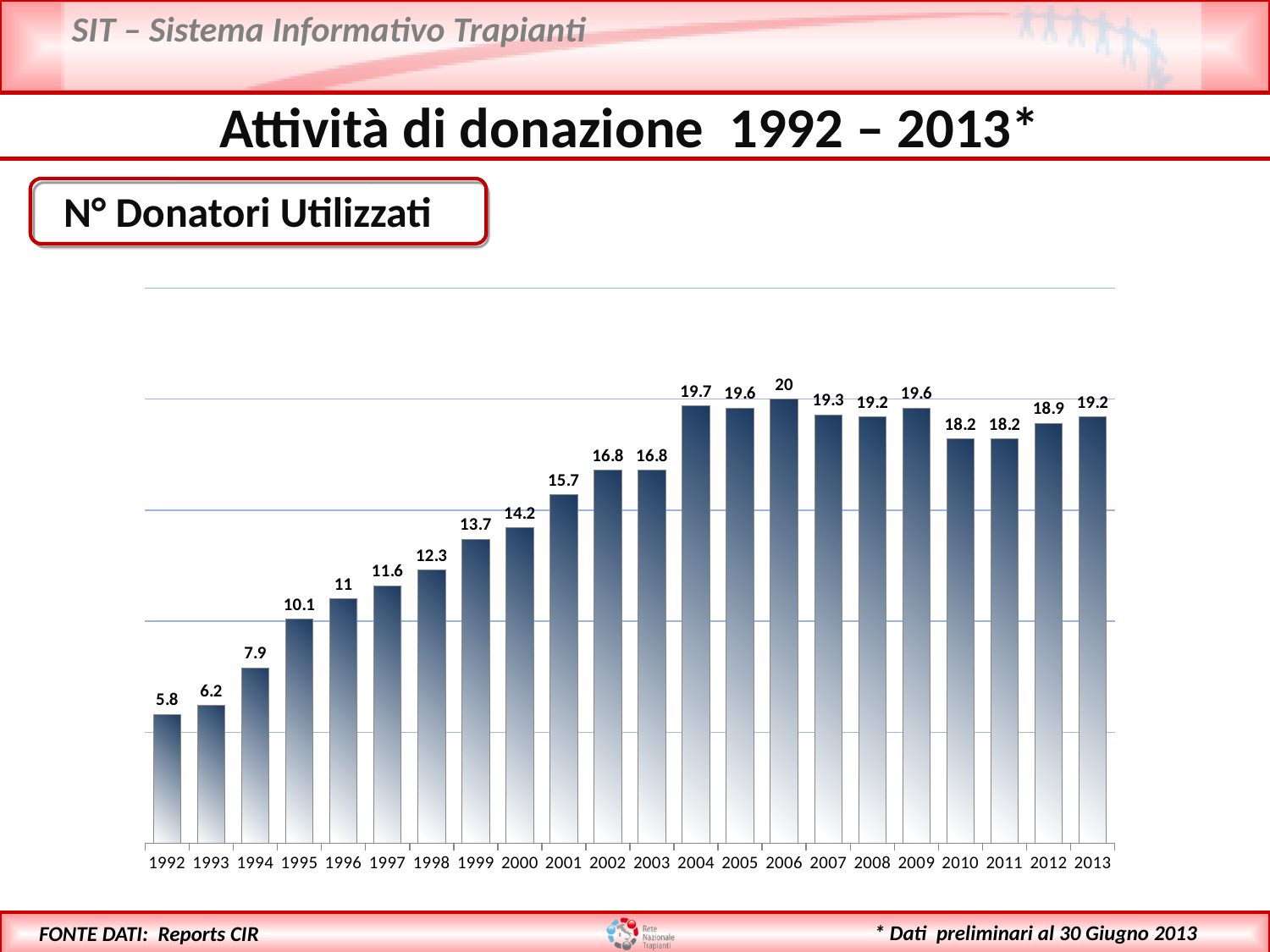
What is the value for 2006? 20 What is the value for 2013? 19.2 What is the difference between the values for 2006 and 1992? 14.2 How many years are shown on the x axis? 22 What is the value for 1992? 5.8 What kind of chart is shown? Bar chart Which is larger, the value for 2004 or the value for 2010? 2004 Which year has the lowest value? 1992 Do the values rise or fall from 1992 to 2004? Rise Which year has the highest value? 2006 What is the difference between the values for 2012 and 2011? 0.7 What is the value for 1999? 13.7